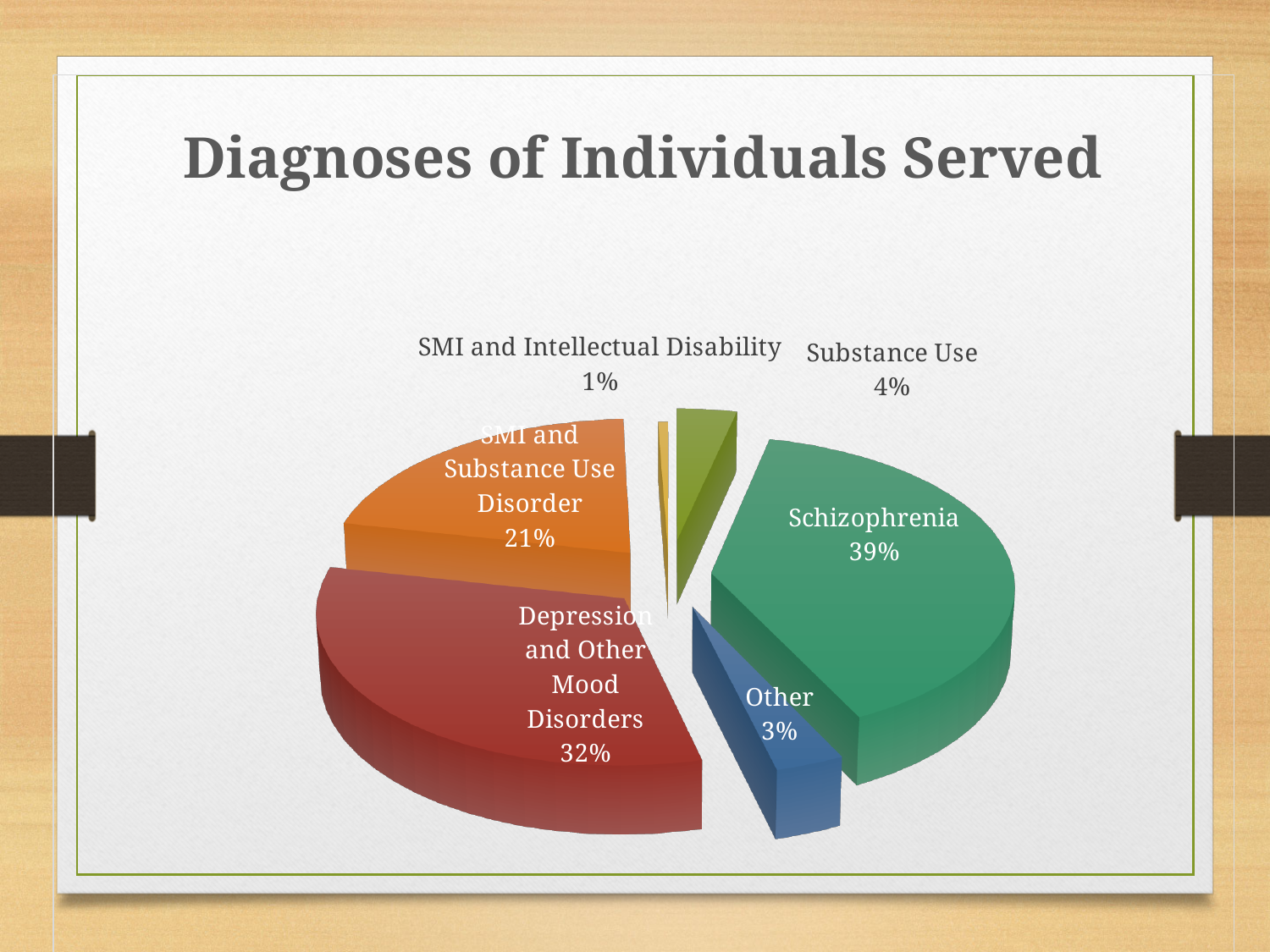
What is the title of the slide containing the pie chart? Diagnoses of Individuals Served What percentage of individuals served have Depression and Other Mood Disorders? 32% What is the difference in percentage points between Schizophrenia and Depression and Other Mood Disorders? 7 What type of chart is shown on the slide? Pie chart What percentage of individuals served have a Substance Use diagnosis? 4% Which diagnosis category has the largest share of individuals served? Schizophrenia Which diagnosis category has the smallest share of individuals served? SMI and Intellectual Disability What percentage of individuals served have a diagnosis of Schizophrenia? 39% What percentage of individuals served have SMI and Intellectual Disability? 1% Which is larger: the share for Substance Use or the share for Other? Substance Use What percentage of individuals served have SMI and Substance Use Disorder? 21% How many diagnosis categories are shown in the pie chart? 6